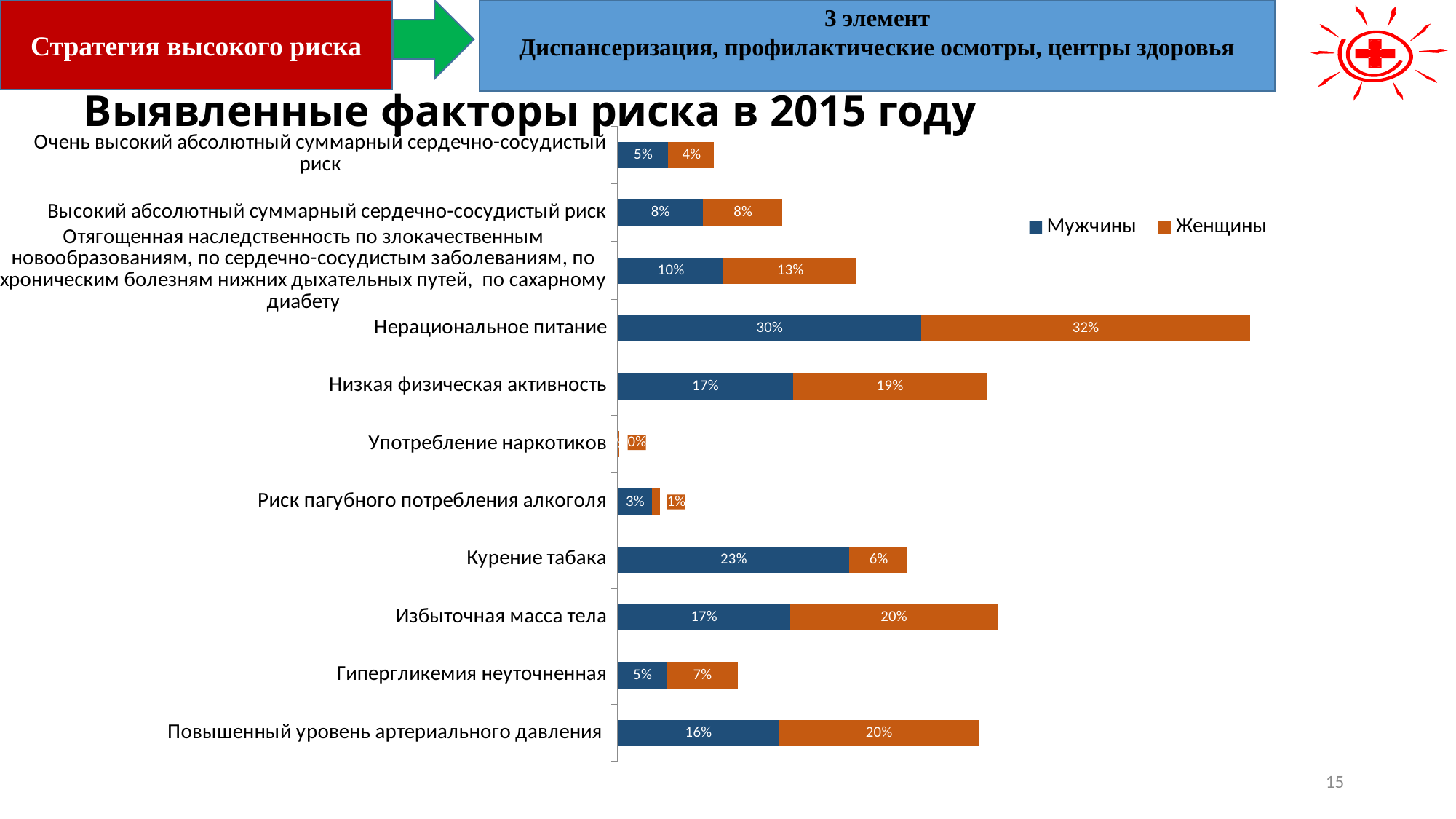
Which category has the highest value for Мужчины? Нерациональное питание What kind of chart is shown on the slide? Stacked bar chart How many categories are shown on the chart? 11 What is the value for Мужчины for Повышенный уровень артериального давления? 16% What is the total of the stacked bar for Низкая физическая активность? 36% What is the difference between the Мужчины and Женщины values for Курение табака? 17% What is the value for Женщины for Нерациональное питание? 32% Which is larger for Гипергликемия неуточненная: the Мужчины value or the Женщины value? Женщины What is the value for Мужчины for Курение табака? 23% What is the value for Женщины for Избыточная масса тела? 20% How many series does the legend list? 2 What is the title of the chart? Выявленные факторы риска в 2015 году